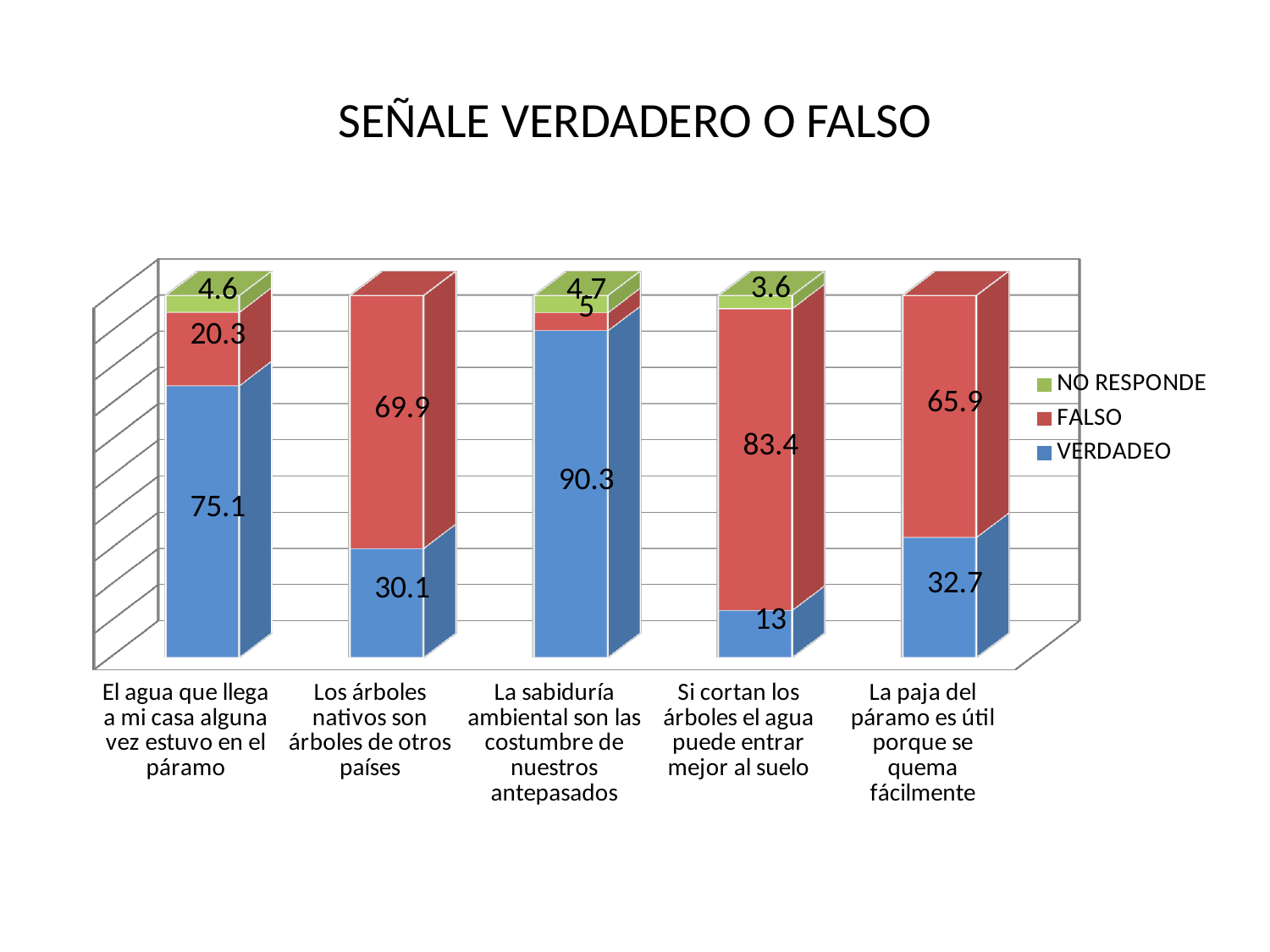
Which category has the lowest VERDADEO value? Si cortan los árboles el agua puede entrar mejor al suelo What is the total of the stacked bar for "Si cortan los árboles el agua puede entrar mejor al suelo"? 100 What is the FALSO value for "Los árboles nativos son árboles de otros países"? 69.9 What is the difference between the FALSO and VERDADEO values for "Los árboles nativos son árboles de otros países"? 39.8 What is the NO RESPONDE value for "Si cortan los árboles el agua puede entrar mejor al suelo"? 3.6 How many series does the legend list? 3 What kind of chart is shown on the slide? Stacked bar chart Which category has the highest VERDADEO value? La sabiduría ambiental son las costumbre de nuestros antepasados How many categories are shown on the x axis? 5 What is the VERDADEO value for "La paja del páramo es útil porque se quema fácilmente"? 32.7 Which is larger for "La paja del páramo es útil porque se quema fácilmente": the FALSO value or the VERDADEO value? FALSO What is the VERDADEO value for "El agua que llega a mi casa alguna vez estuvo en el páramo"? 75.1